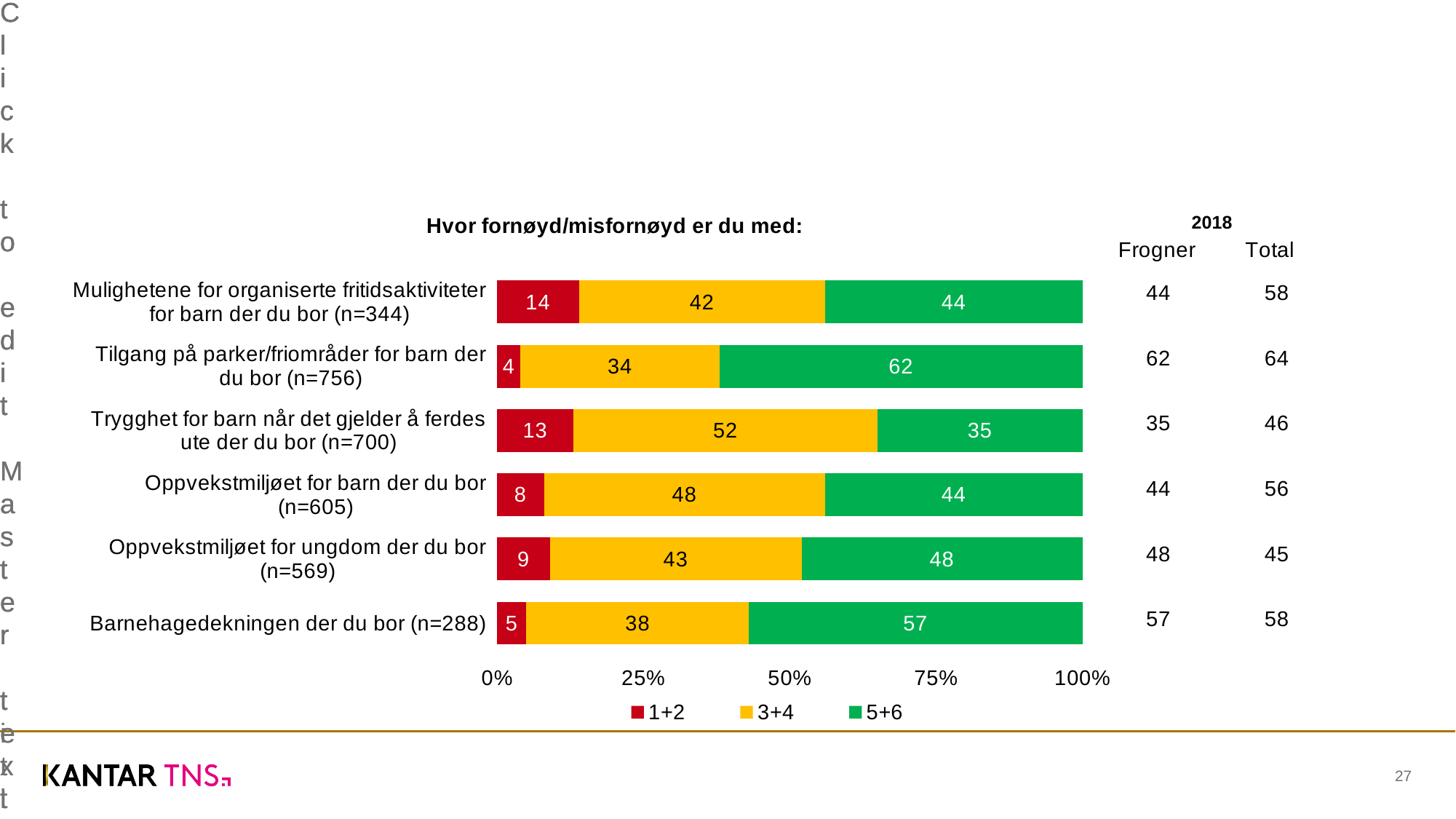
What is the title of the chart? Hvor fornøyd/misfornøyd er du med: Which is larger: the 3+4 value for 'Oppvekstmiljøet for barn der du bor (n=605)' or for 'Oppvekstmiljøet for ungdom der du bor (n=569)'? Oppvekstmiljøet for barn der du bor (n=605) Which category has the lowest 1+2 value? Tilgang på parker/friområder for barn der du bor (n=756) How many categories (questions) are plotted in the chart? 6 What is the Total value for 2018 shown next to 'Oppvekstmiljøet for ungdom der du bor (n=569)'? 45 What is the difference between the 5+6 values for 'Barnehagedekningen der du bor (n=288)' and 'Trygghet for barn når det gjelder å ferdes ute der du bor (n=700)'? 22 What kind of chart is shown on the slide? Stacked bar chart How many series does the legend list? 3 What is the 3+4 value for 'Trygghet for barn når det gjelder å ferdes ute der du bor (n=700)'? 52 What is the 1+2 value for 'Mulighetene for organiserte fritidsaktiviteter for barn der du bor (n=344)'? 14 What is the 5+6 value for 'Tilgang på parker/friområder for barn der du bor (n=756)'? 62 Which category has the highest 5+6 value? Tilgang på parker/friområder for barn der du bor (n=756)